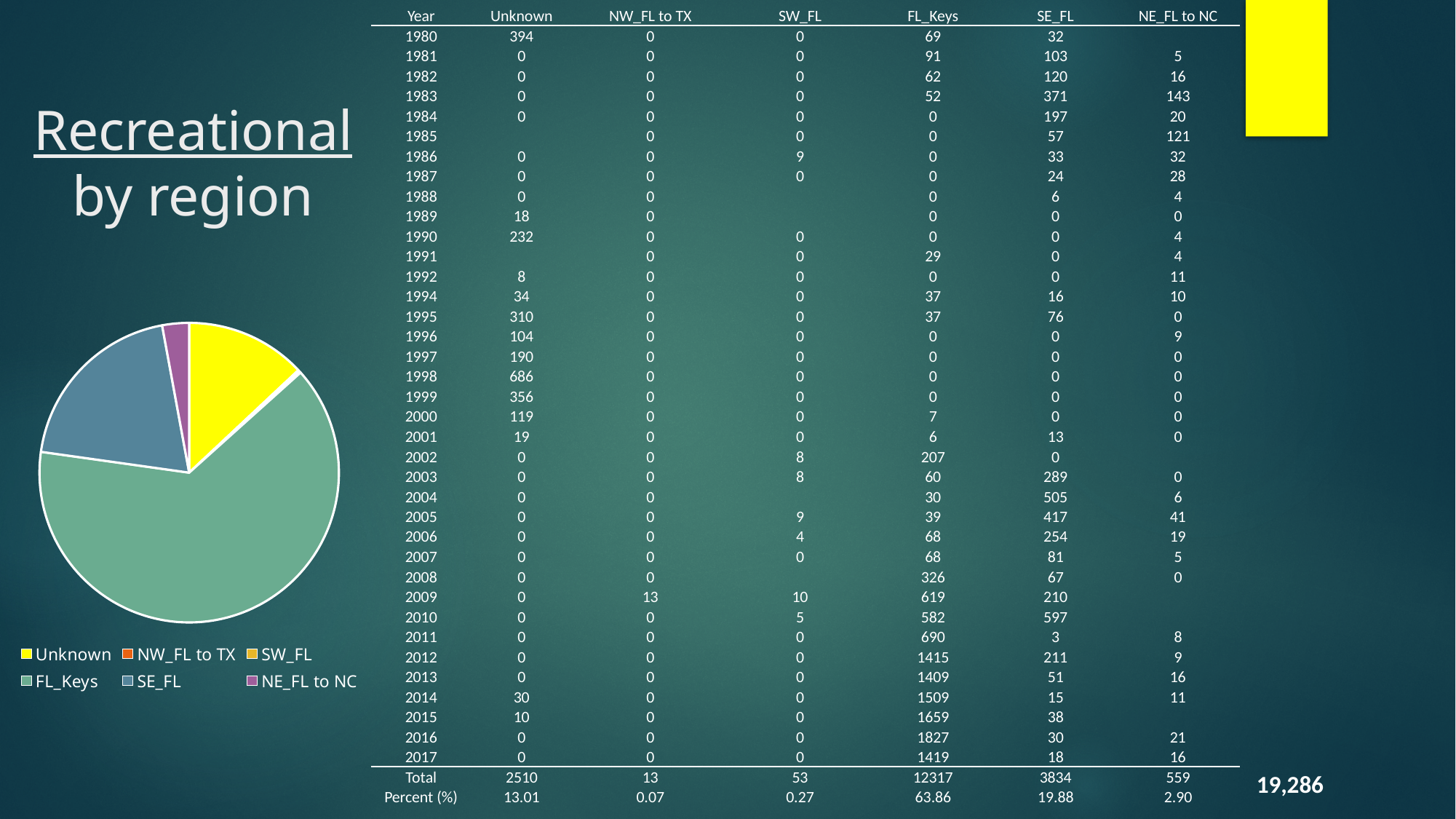
What colour is the Unknown slice in the pie chart? yellow How many categories does the pie chart's legend list? 6 Which slice is larger in the pie chart, SE_FL or NE_FL to NC? SE_FL Which slice is larger in the pie chart, Unknown or SE_FL? SE_FL Which slice is larger in the pie chart, FL_Keys or Unknown? FL_Keys What kind of chart is shown on the slide? pie chart Does the FL_Keys slice take up more or less than half of the pie chart? more Which region has the largest slice in the pie chart? FL_Keys According to the Percent (%) row of the table, what share of the total does SE_FL represent? 19.88 According to the Percent (%) row of the table, what share of the total does FL_Keys represent? 63.86 What colour is the FL_Keys slice in the pie chart? green